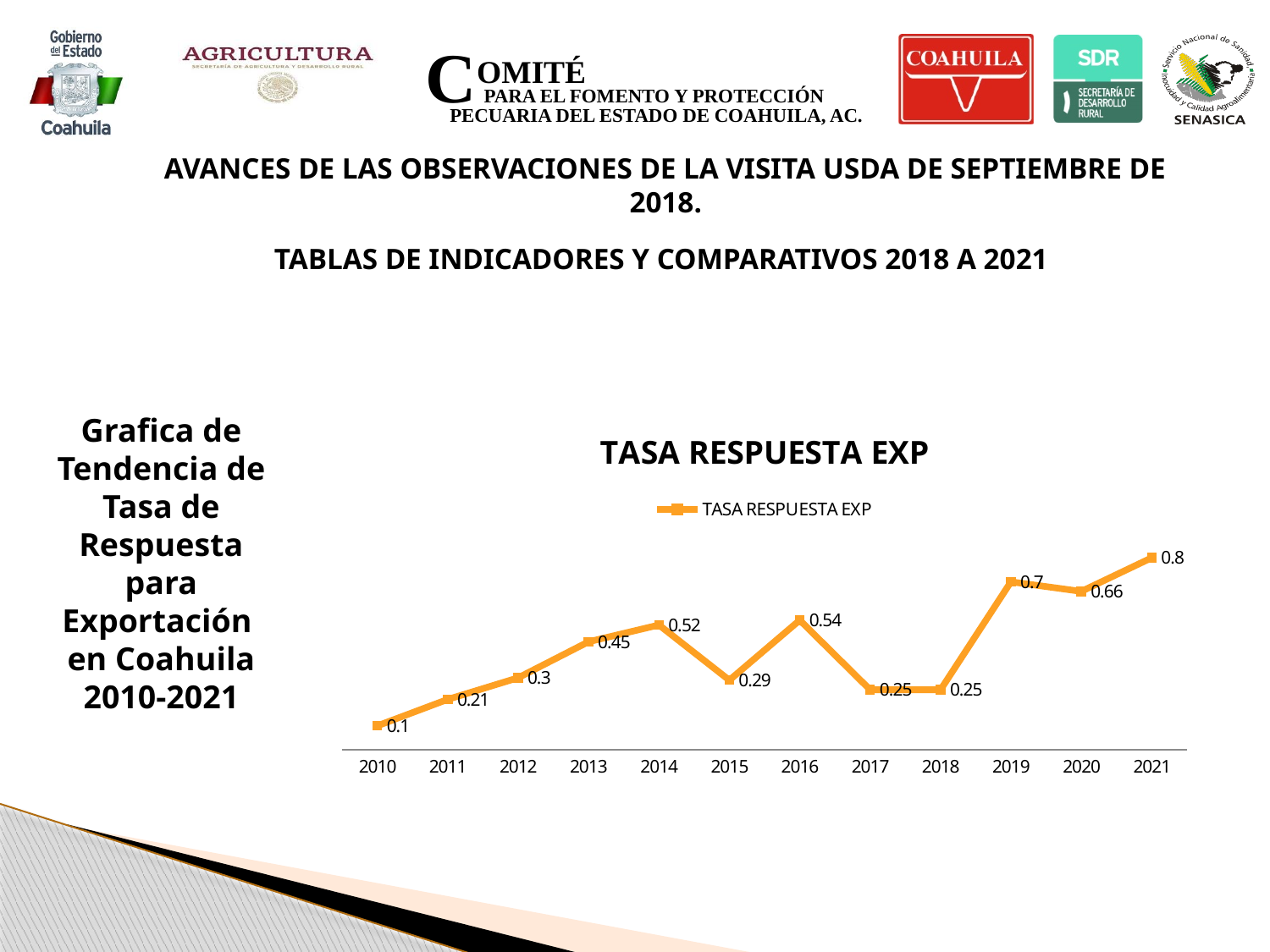
How many years are plotted in the TASA RESPUESTA EXP chart? 12 Which year has the lowest value in the TASA RESPUESTA EXP chart? 2010 Does the value in the TASA RESPUESTA EXP chart rise or fall from 2010 to 2014? Rise What kind of chart is the TASA RESPUESTA EXP chart? Line chart What is the title of the chart on the slide? TASA RESPUESTA EXP What is the value for 2019 in the TASA RESPUESTA EXP chart? 0.7 Which is larger in the TASA RESPUESTA EXP chart, the value for 2016 or the value for 2015? 2016 What is the value for 2014 in the TASA RESPUESTA EXP chart? 0.52 What is the difference between the values for 2021 and 2020 in the TASA RESPUESTA EXP chart? 0.14 What is the value for 2010 in the TASA RESPUESTA EXP chart? 0.1 Which year has the highest value in the TASA RESPUESTA EXP chart? 2021 How many series does the legend of the TASA RESPUESTA EXP chart list? 1